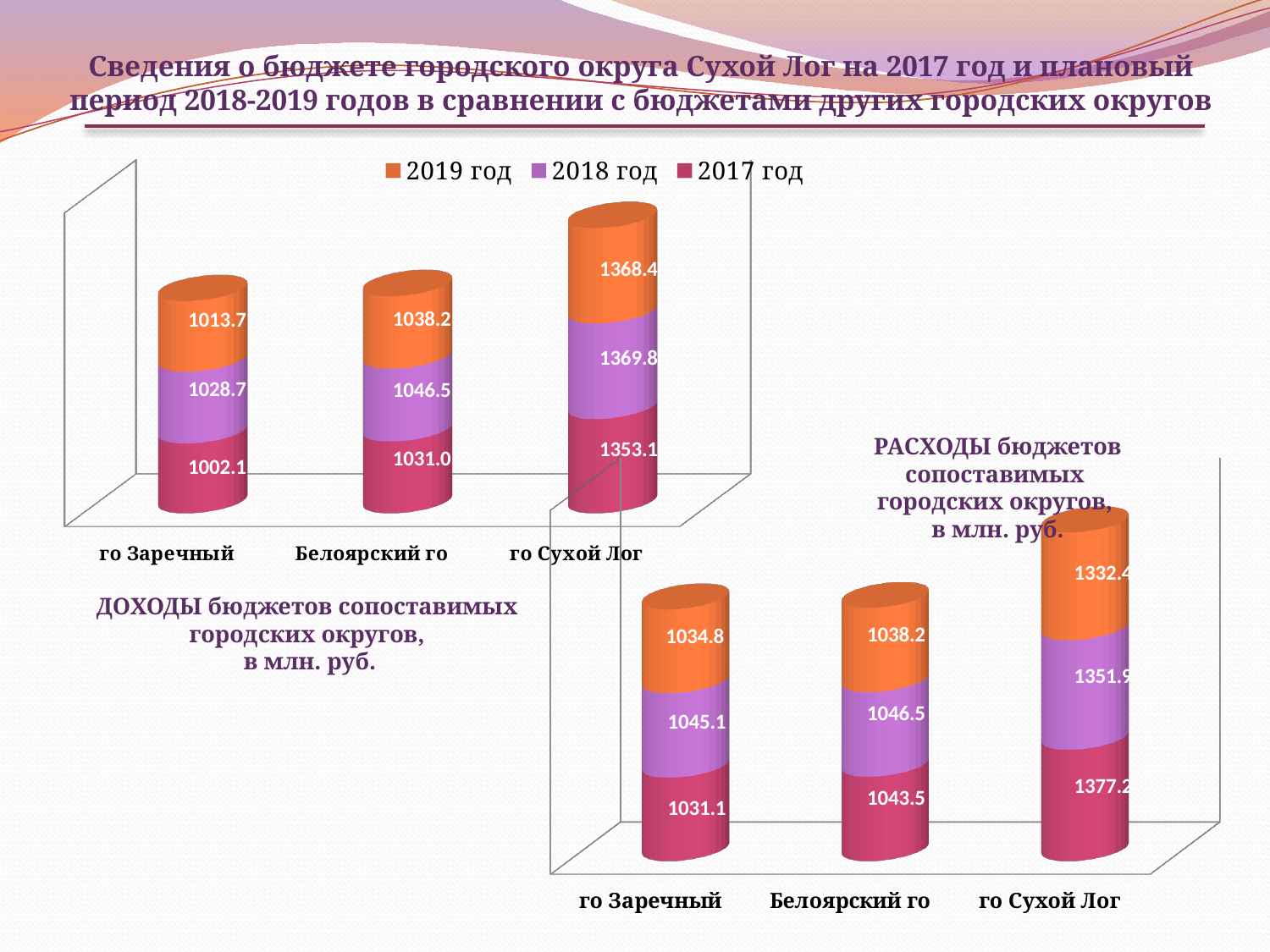
In the РАСХОДЫ (expenses) chart, which city district has the lowest 2017 год value? го Заречный What type of chart is the ДОХОДЫ (incomes) chart? Stacked bar chart In the ДОХОДЫ (incomes) chart, what is the 2017 год value for го Заречный? 1002.1 How many series does the legend at the top of the slide list? 3 In the РАСХОДЫ (expenses) chart, what is the 2017 год value for го Сухой Лог? 1377.2 In the ДОХОДЫ (incomes) chart, which city district has the highest 2019 год value? го Сухой Лог In the ДОХОДЫ (incomes) chart, what is the difference between the 2017 год values for го Сухой Лог and го Заречный? 351.0 In the ДОХОДЫ (incomes) chart, what is the total of the stacked bar for го Сухой Лог? 4091.3 In the РАСХОДЫ (expenses) chart, which is larger: the 2018 год value for го Заречный or for Белоярский го? Белоярский го How many city districts are shown on the x axis of the РАСХОДЫ (expenses) chart? 3 In the РАСХОДЫ (expenses) chart, what is the 2019 год value for Белоярский го? 1038.2 In the ДОХОДЫ (incomes) chart, what is the 2018 год value for го Сухой Лог? 1369.8